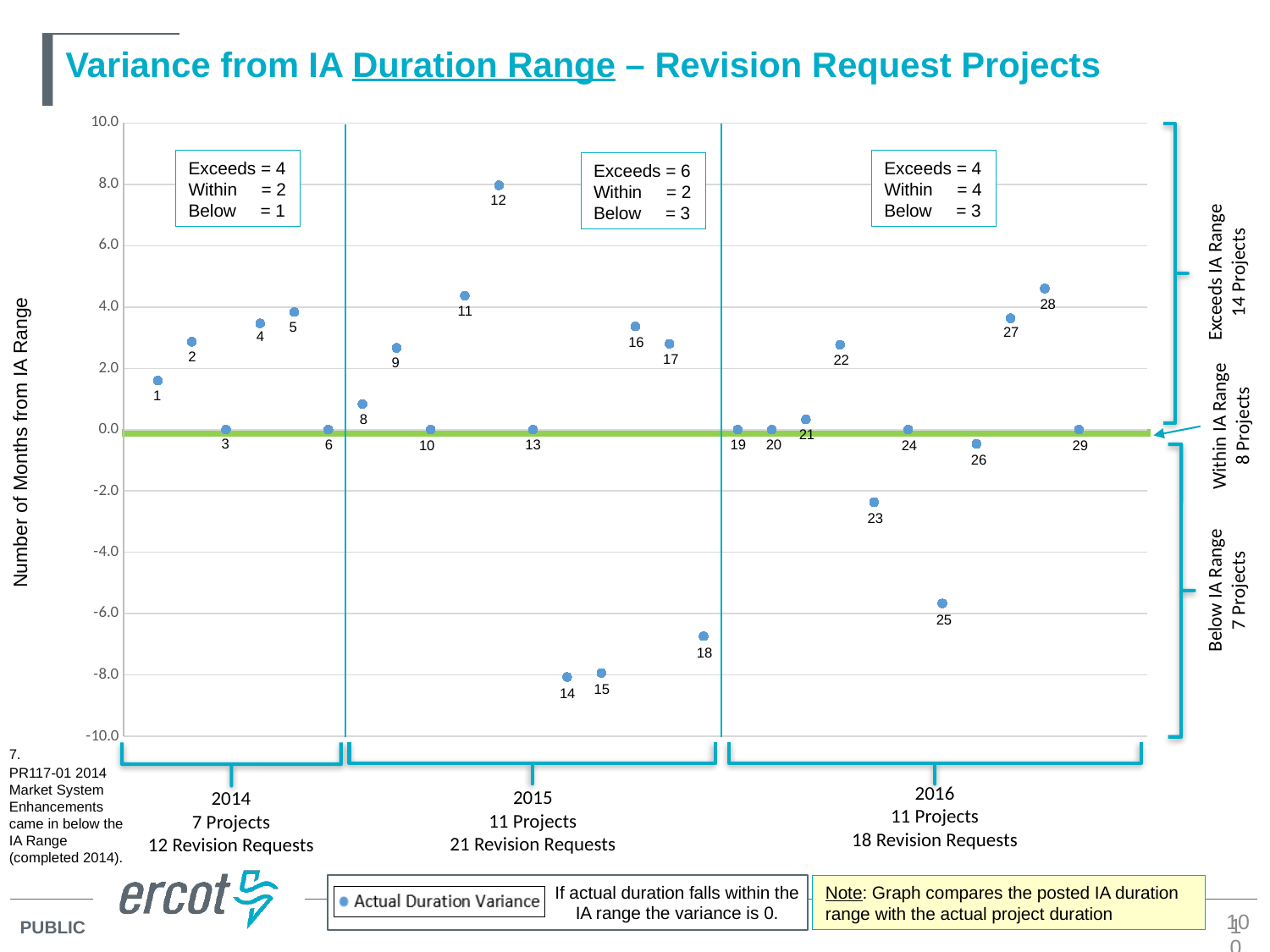
Is the value for point 25 greater or less than -4.0? less Is the value for point 14 greater or less than -6.0? less Is the value for point 28 greater or less than 4.0? greater How many series does the legend list? 1 Which has the larger value, point 2 or point 5? point 5 Which numbered point has the highest value on the chart? 12 What is the name of the series shown in the legend? Actual Duration Variance What kind of chart is shown on the slide? scatter chart How many data points are plotted on the chart? 28 What is the title of the vertical axis? Number of Months from IA Range Which has the larger value, point 12 or point 28? point 12